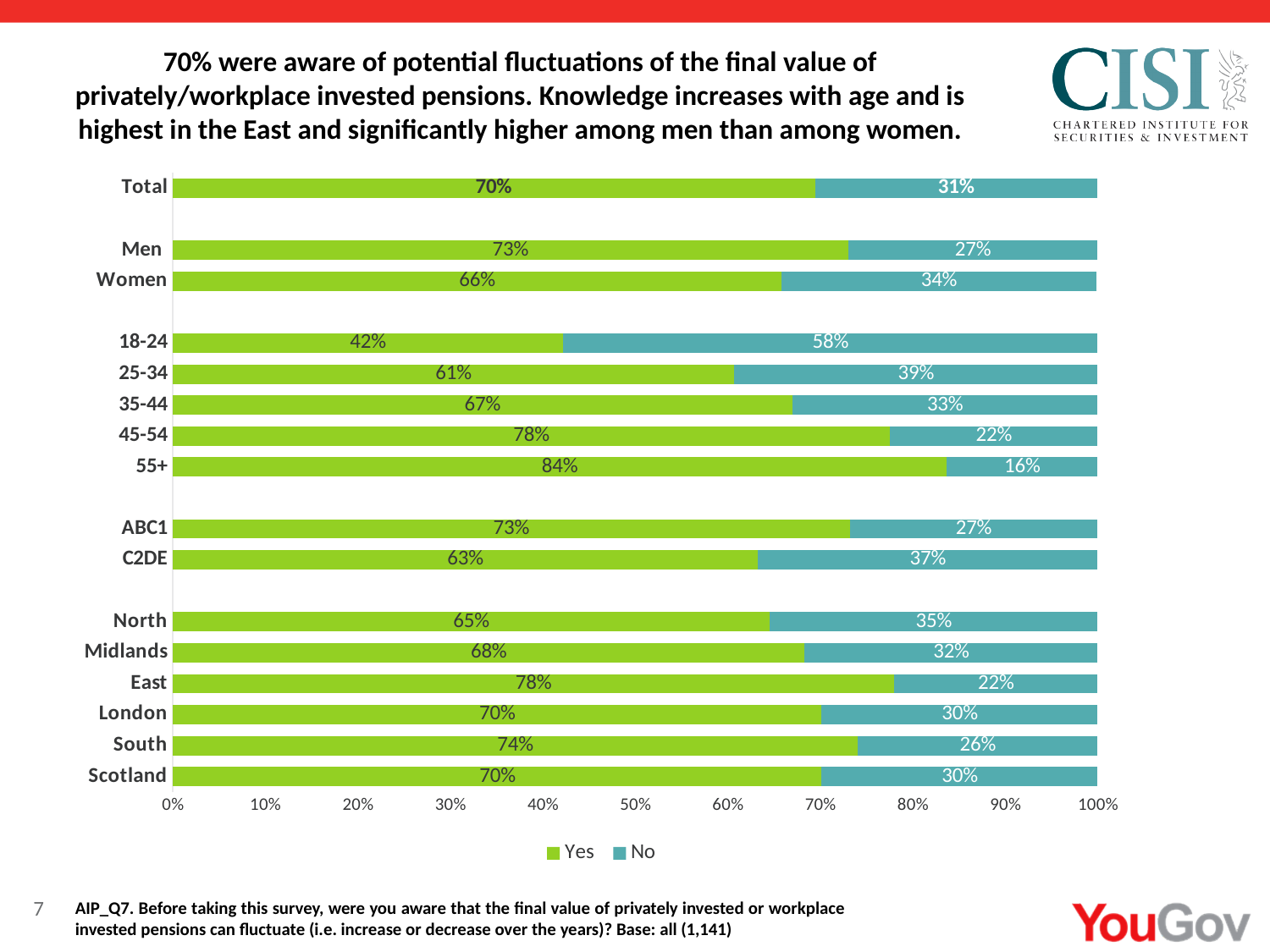
Which colour represents the 'No' series? Teal What is the 'No' value for the 18-24 age group? 58% Which category has the highest 'Yes' value? 55+ What is the difference between the 'Yes' values for Men and Women? 7% Which category has the lowest 'Yes' value? 18-24 How many series does the legend list? 2 Do the 'Yes' values rise or fall as the age groups get older, from 18-24 to 55+? Rise What is the 'Yes' value for Women? 66% What is the 'Yes' value for the 55+ age group? 84% What kind of chart is shown on the slide? Stacked bar chart Which has a larger 'Yes' value, East or Midlands? East What is the total of the stacked bar for the 45-54 age group? 100%